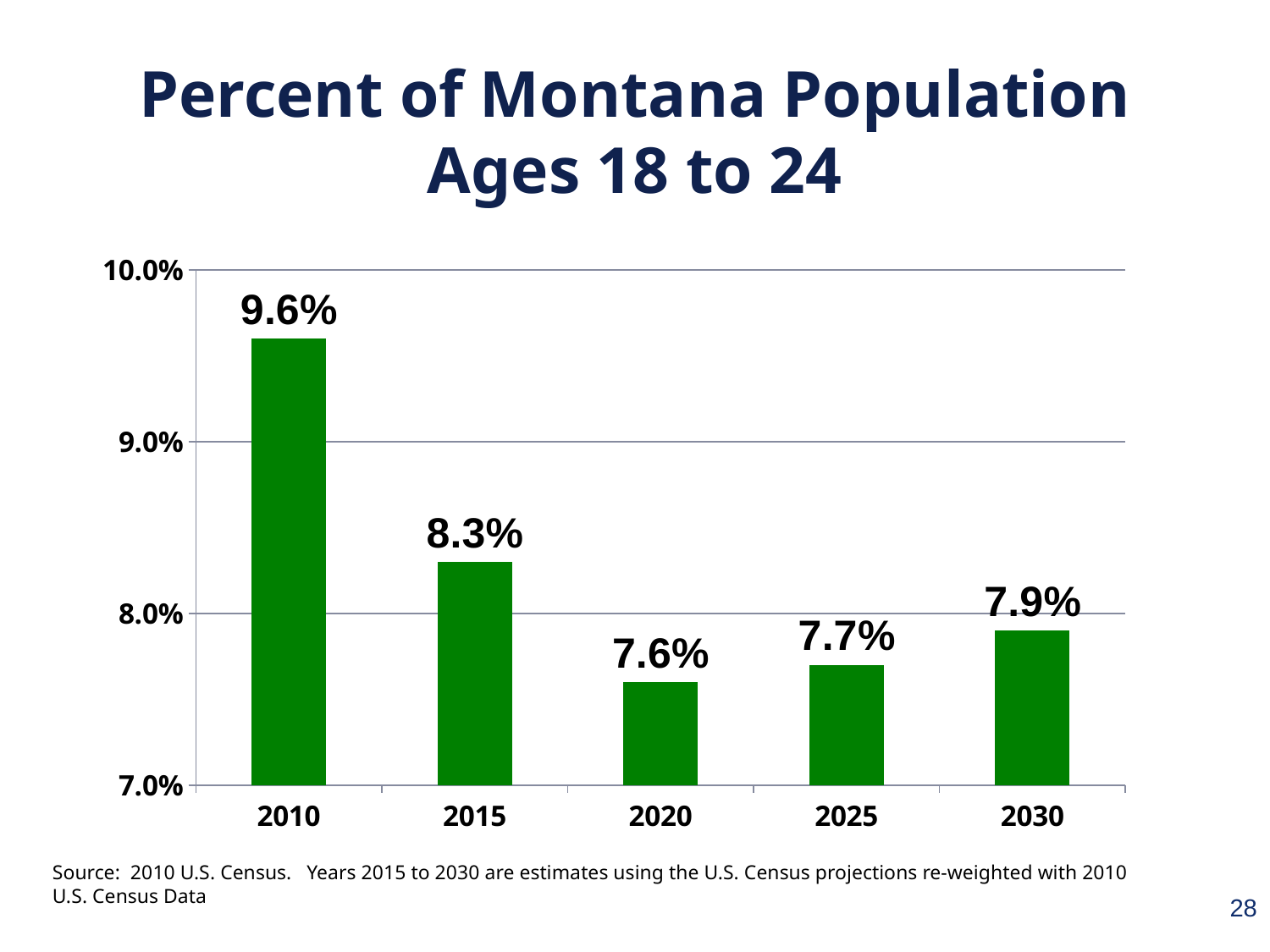
What is the value shown for 2030? 7.9% What kind of chart is shown on the slide? Bar chart What is the value shown for 2020? 7.6% Which year has the lowest percent of Montana population ages 18 to 24? 2020 Does the percent of Montana population ages 18 to 24 rise or fall from 2010 to 2020? Fall What is the difference between the values for 2010 and 2015? 1.3% What is the percent of Montana population ages 18 to 24 in 2010? 9.6% What is the difference between the values for 2030 and 2020? 0.3% Which year has the highest percent of Montana population ages 18 to 24? 2010 How many years are shown on the x axis? 5 Which is larger, the value for 2015 or the value for 2030? 2015 Is the value for 2025 greater or less than 8.0%? less